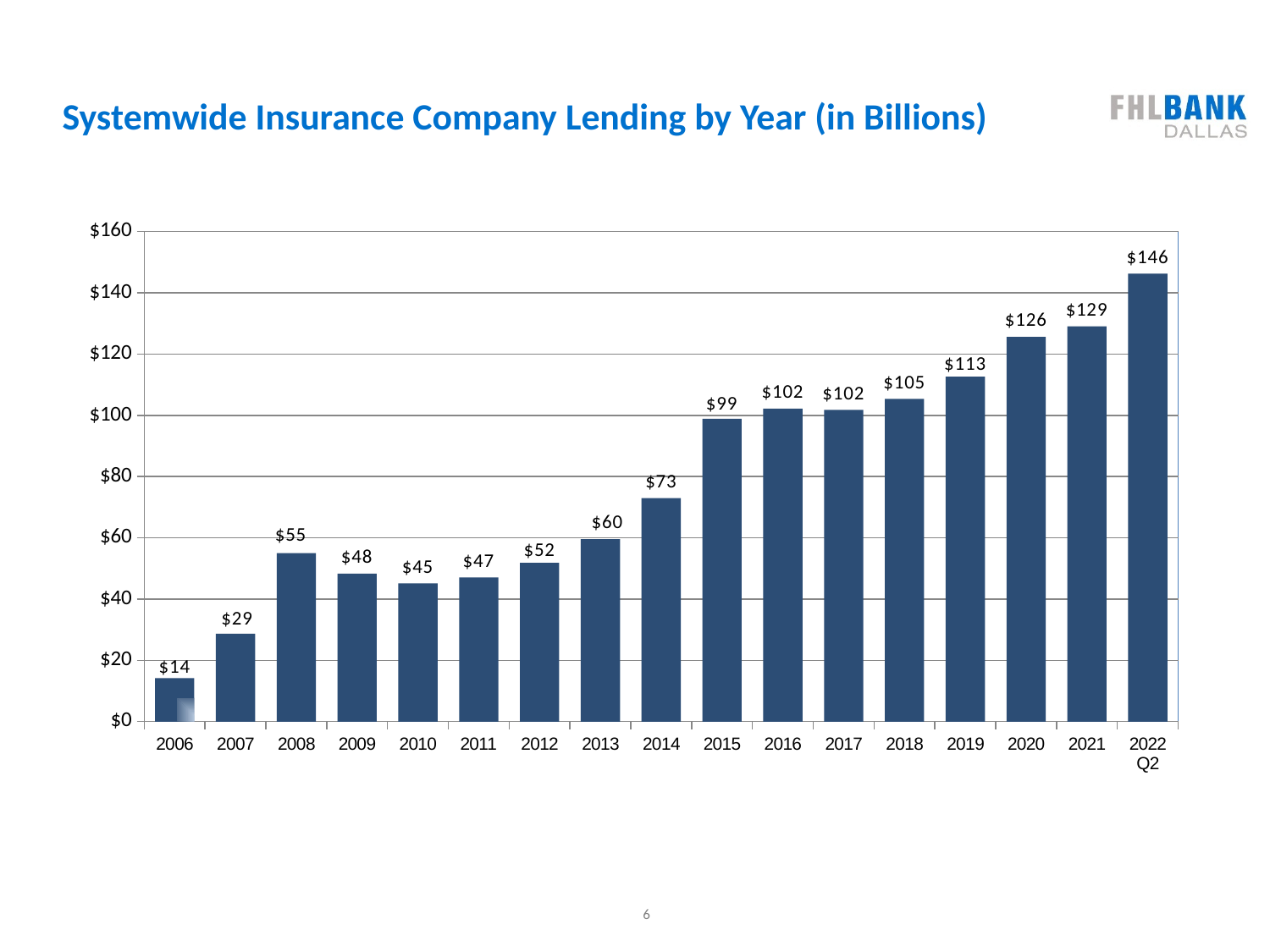
What is the difference between the values for 2021 and 2020? $3 What is the value for 2015? $99 What is the value for 2008? $55 What is the value for 2022 Q2? $146 How many bars are shown in the chart? 17 Which year has the lowest value? 2006 What is the title of the chart? Systemwide Insurance Company Lending by Year (in Billions) Which is larger, the value for 2009 or the value for 2010? 2009 What is the difference between the values for 2014 and 2013? $13 Is the value for 2019 greater or less than $100? greater Which year has the highest value? 2022 Q2 What kind of chart is shown on the slide? bar chart